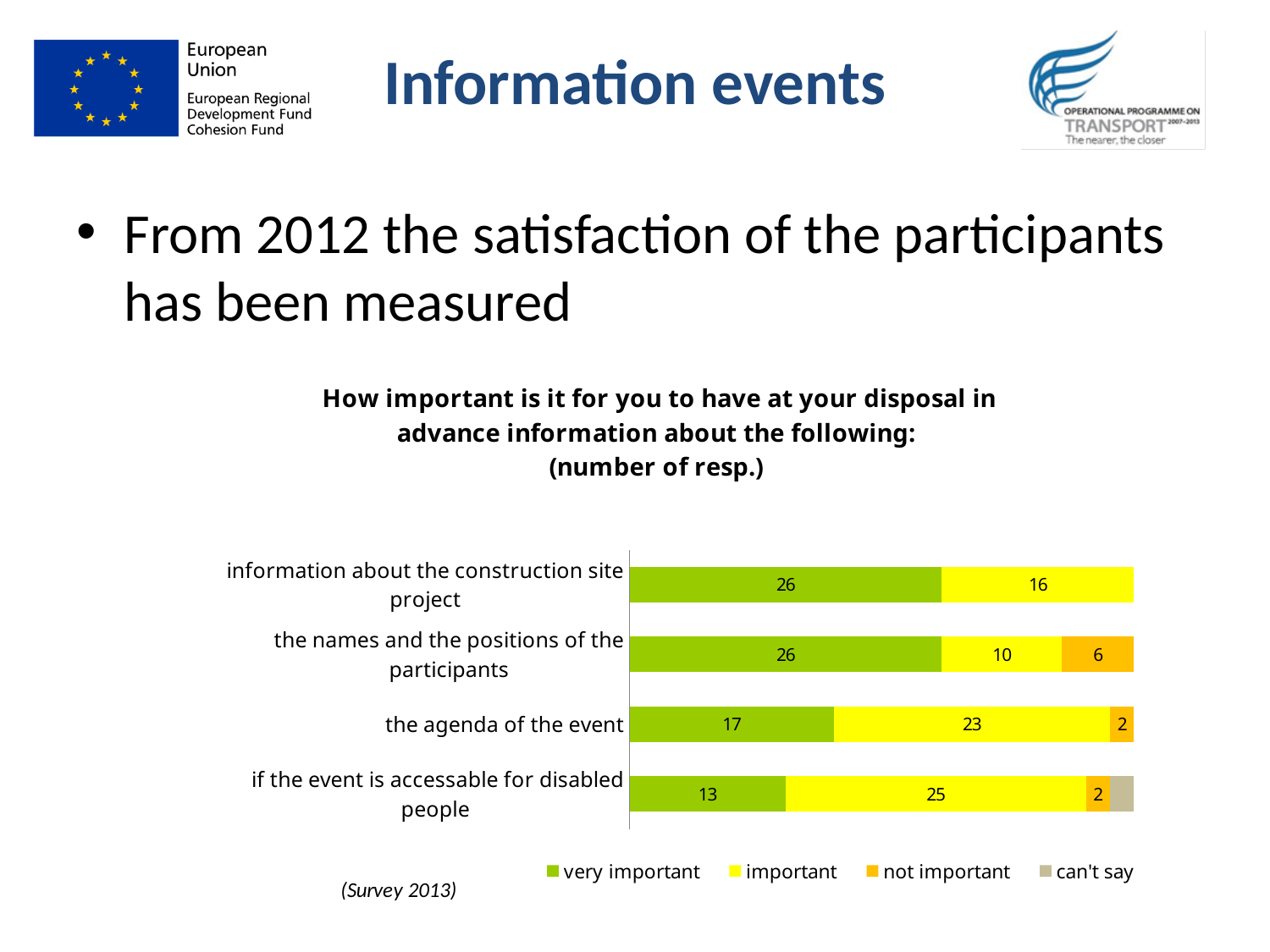
How many respondents rated 'if the event is accessable for disabled people' as important? 25 How many categories are plotted in the chart? 4 What is the difference between the 'very important' and 'important' counts for 'information about the construction site project'? 10 Which category has the highest number of 'important' responses? if the event is accessable for disabled people Which category has the lowest number of 'very important' responses? if the event is accessable for disabled people What kind of chart is shown on the slide? stacked bar chart How many respondents rated 'the names and the positions of the participants' as not important? 6 Which has more 'important' responses: 'the agenda of the event' or 'the names and the positions of the participants'? the agenda of the event What is the total number of respondents for 'the names and the positions of the participants'? 42 Which legend entry is shown in grey? can't say How many respondents rated 'the agenda of the event' as very important? 17 How many series does the legend list? 4